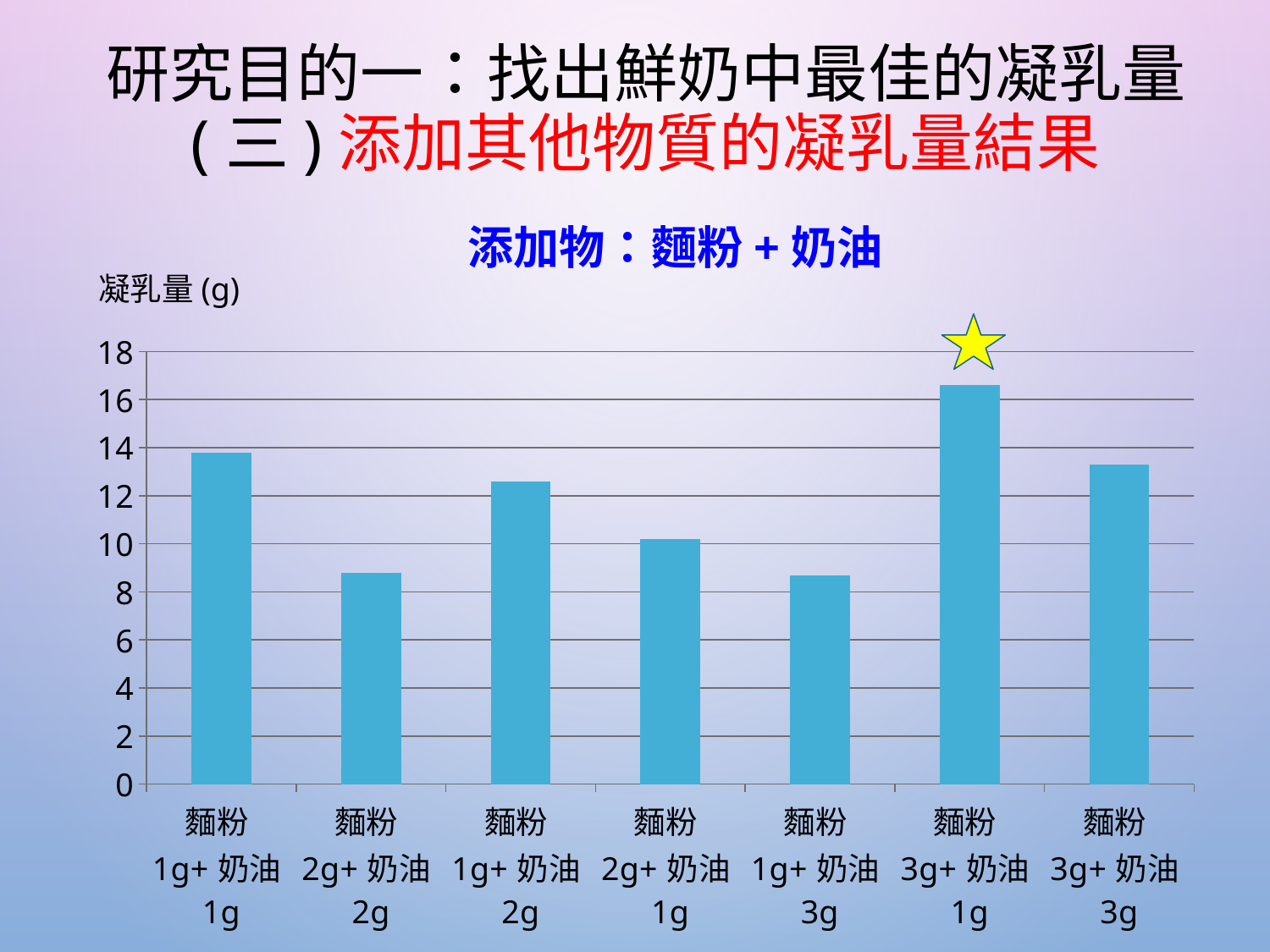
Which is larger, the value for 麵粉1g+奶油2g or the value for 麵粉2g+奶油1g? 麵粉1g+奶油2g What is the label of the vertical axis? 凝乳量 (g) Is the value for 麵粉3g+奶油1g greater or less than 16? greater How many bars (categories) does the chart show? 7 Is the value for 麵粉2g+奶油2g greater or less than 10? less Is the value for 麵粉3g+奶油3g greater or less than 12? greater What is the title shown above the chart? 添加物：麵粉 + 奶油 What kind of chart is shown on the slide? bar chart Which category has the highest 凝乳量? 麵粉3g+奶油1g